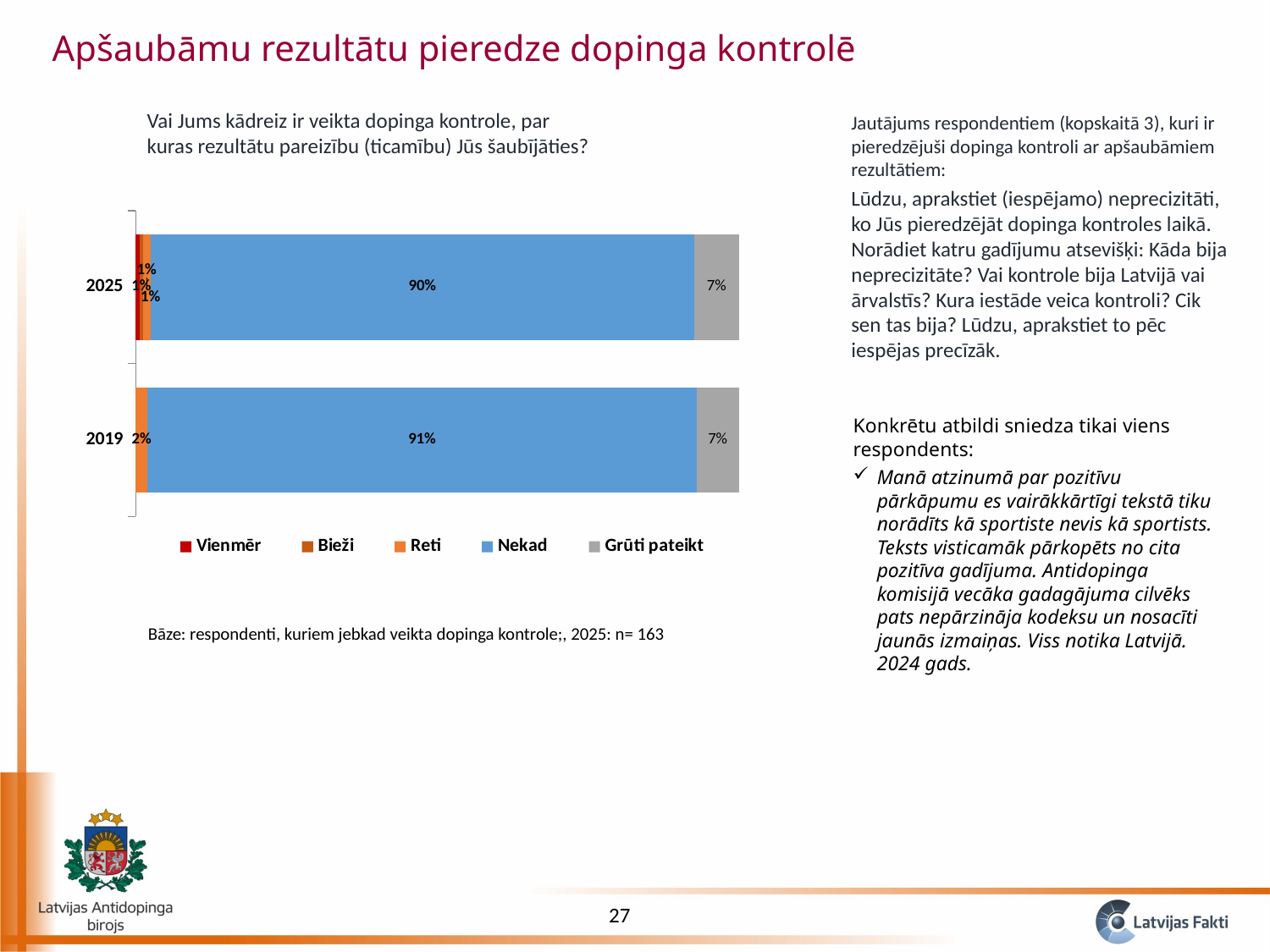
Which answer category has the largest share in the 2025 bar? Nekad How many series does the legend list? 5 How many years (categories) are shown in the chart? 2 What is the value for "Reti" in 2019? 2% Which answer category has the smallest share in the 2019 bar? Reti Is the "Nekad" value larger in 2025 or in 2019? 2019 What percentage of respondents answered "Nekad" in 2019? 91% What percentage of respondents answered "Nekad" in 2025? 90% What is the value for "Grūti pateikt" in 2025? 7% What is the difference between the "Nekad" values for 2019 and 2025? 1 percentage point What kind of chart is shown on the slide? Stacked bar chart What is the total of the 2019 stacked bar? 100%